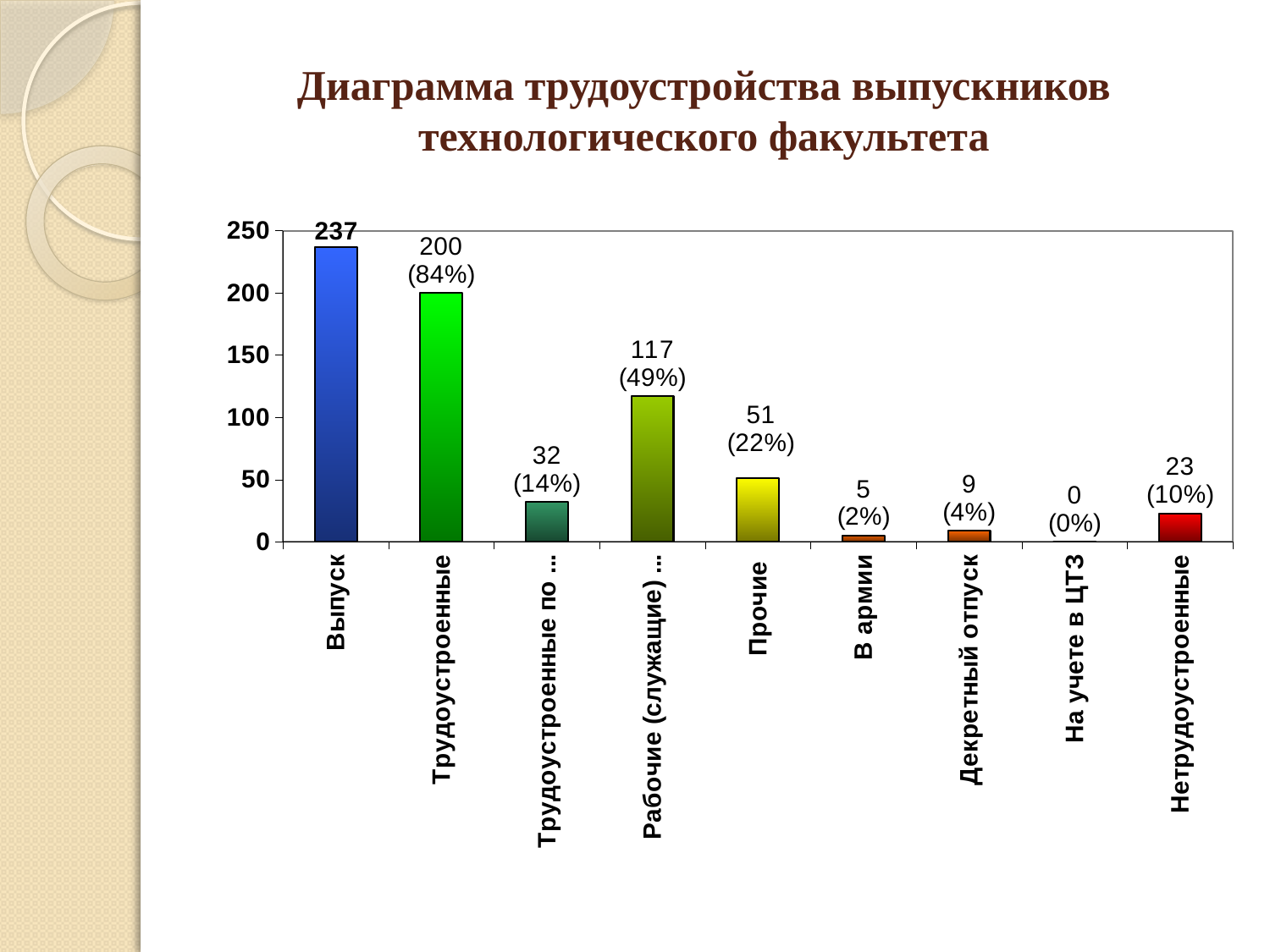
How many categories are shown on the x axis? 9 What percentage is shown for Прочие? 22% What is the value for Выпуск? 237 Which is larger, the value for В армии or the value for Декретный отпуск? Декретный отпуск What kind of chart is shown on the slide? Bar chart What is the difference between the values for Выпуск and Трудоустроенные? 37 What is the value for Декретный отпуск? 9 Which category has the highest value? Выпуск What is the value for Нетрудоустроенные? 23 What is the title of the slide? Диаграмма трудоустройства выпускников технологического факультета What is the value for Трудоустроенные? 200 Which category has the lowest value? На учете в ЦТЗ